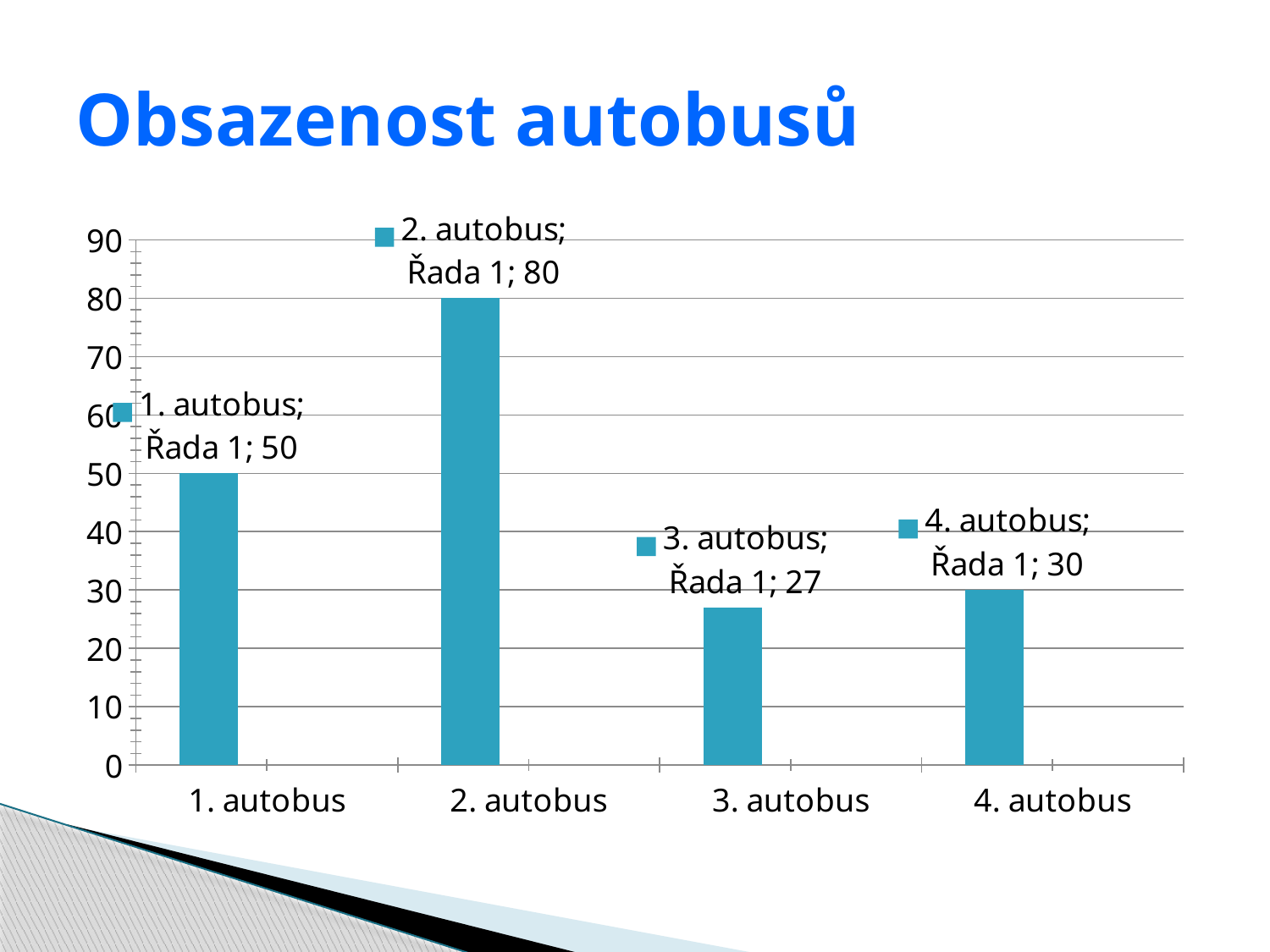
What is the value for 1. autobus? 50 How many categories are shown on the x axis? 4 What is the value for 4. autobus? 30 Which is larger, the value for 1. autobus or the value for 4. autobus? 1. autobus What is the difference between the values for 2. autobus and 1. autobus? 30 Which bus has the highest value? 2. autobus Which bus has the lowest value? 3. autobus What is the value for 2. autobus? 80 What is the title of the slide? Obsazenost autobusů What is the difference between the values for 4. autobus and 3. autobus? 3 What is the value for 3. autobus? 27 What kind of chart is shown on the slide? bar chart